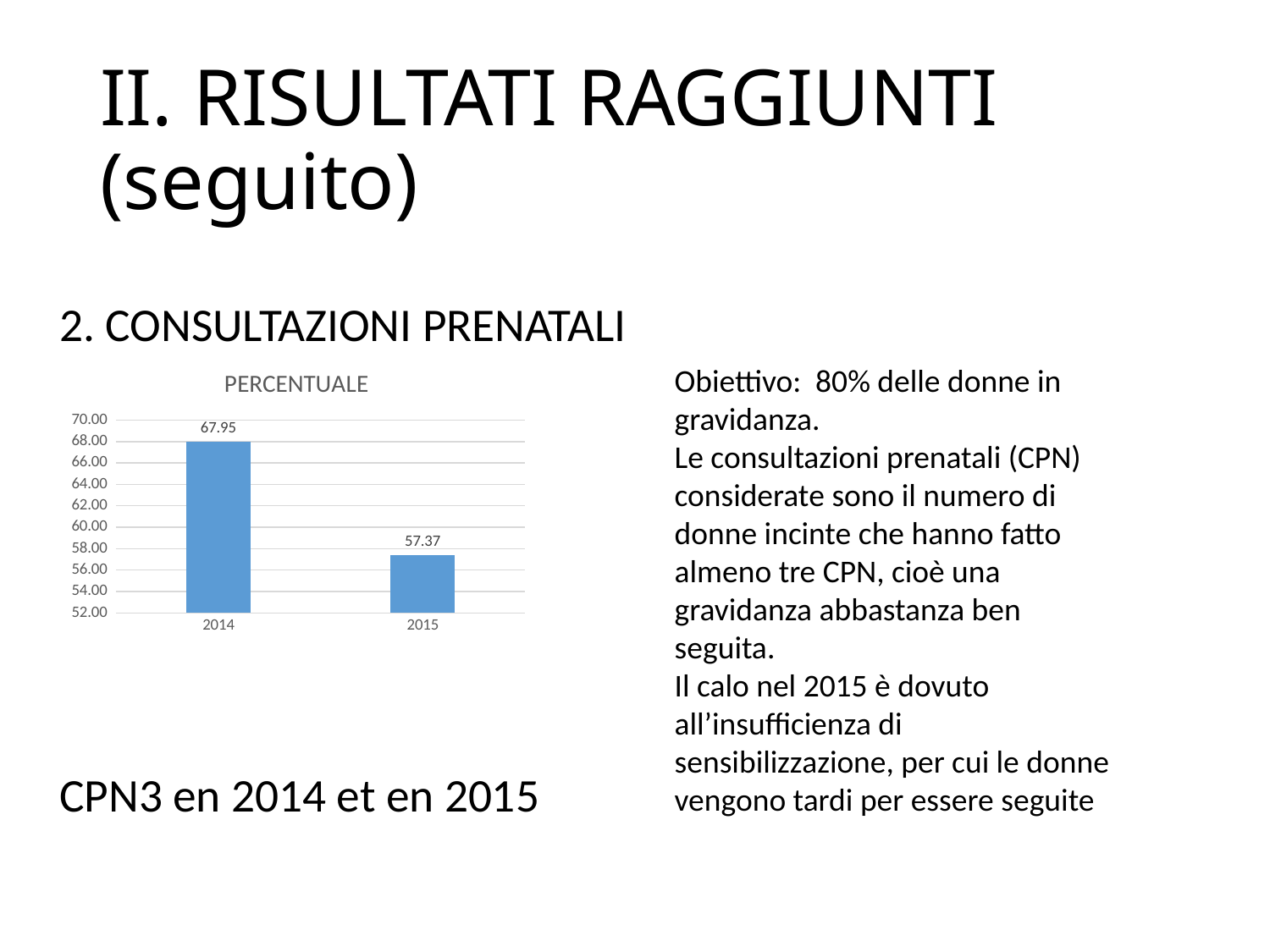
What is the value for 2015 in the PERCENTUALE chart? 57.37 Is the value for 2014 greater or less than 66.00? greater What kind of chart is shown on the slide? bar chart What is the title of the chart? PERCENTUALE How many categories are shown on the x axis of the chart? 2 What is the difference between the 2014 and 2015 values? 10.58 Is the value for 2015 greater or less than 60.00? less Which year has the lowest value in the chart? 2015 Which year has the highest value in the chart? 2014 What is the value for 2014 in the PERCENTUALE chart? 67.95 Do the values rise or fall from 2014 to 2015? fall Which is larger, the value for 2014 or the value for 2015? 2014